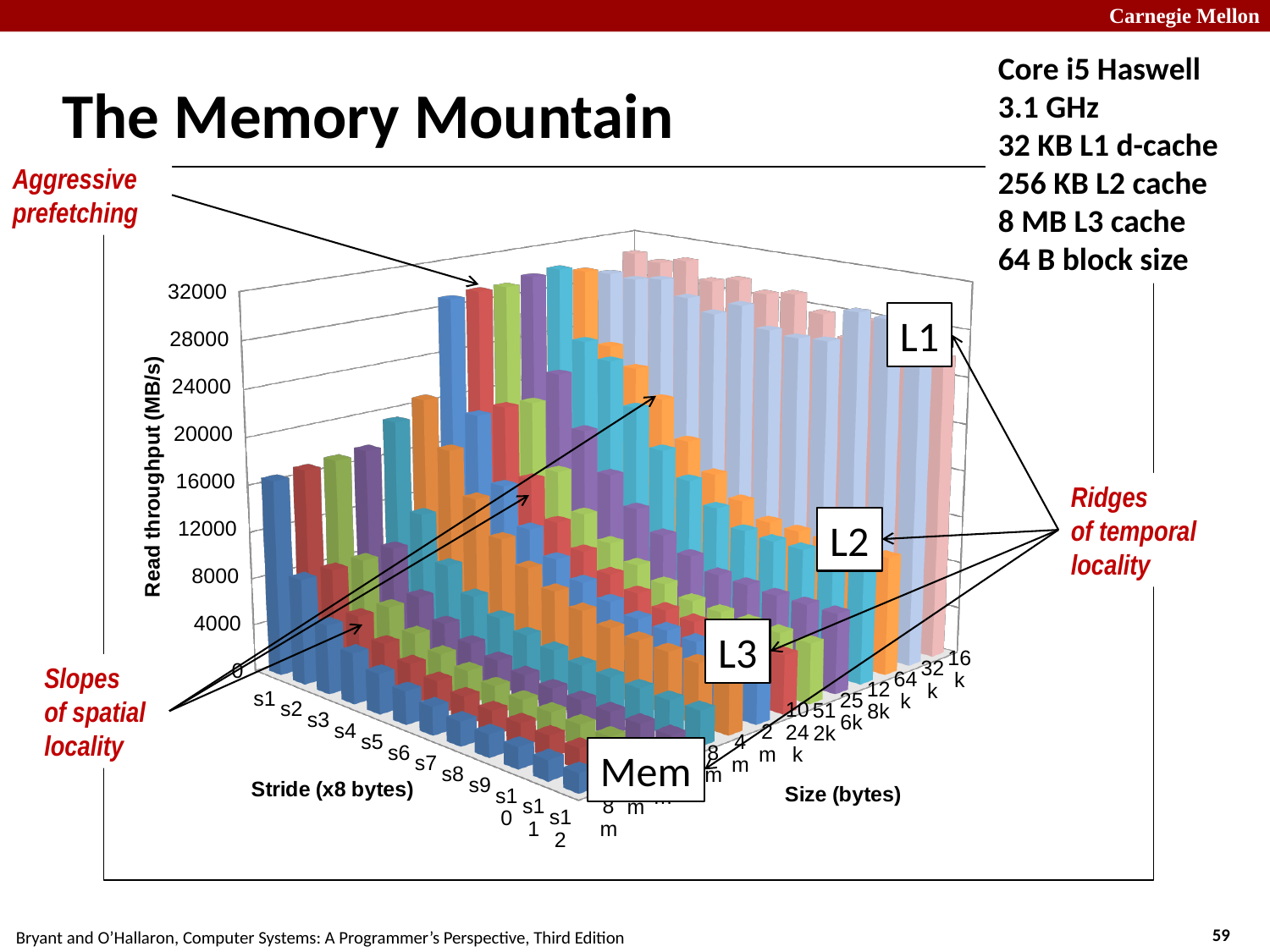
As the working-set size increases from 16k toward 128m for a given stride, does read throughput rise or fall? fall What is the label of the vertical axis of the chart? Read throughput (MB/s) What kind of chart is shown on the slide? 3D bar chart What is the highest tick value shown on the read throughput axis? 32000 Is the read throughput for stride s1 at size 128m greater or less than 24000? less What is the title of the slide's chart? The Memory Mountain Which labeled region of the chart (L1, L2, L3, or Mem) has the lowest read throughput? Mem What is the interval between consecutive ticks on the read throughput axis? 4000 How many stride categories (s1 through s12) are shown along the stride axis? 12 As the stride increases from s1 to s12 for a given size, does read throughput rise or fall? fall Which labeled region of the chart (L1, L2, L3, or Mem) has the highest read throughput? L1 Is the read throughput for stride s1 at size 128m greater or less than 8000? greater